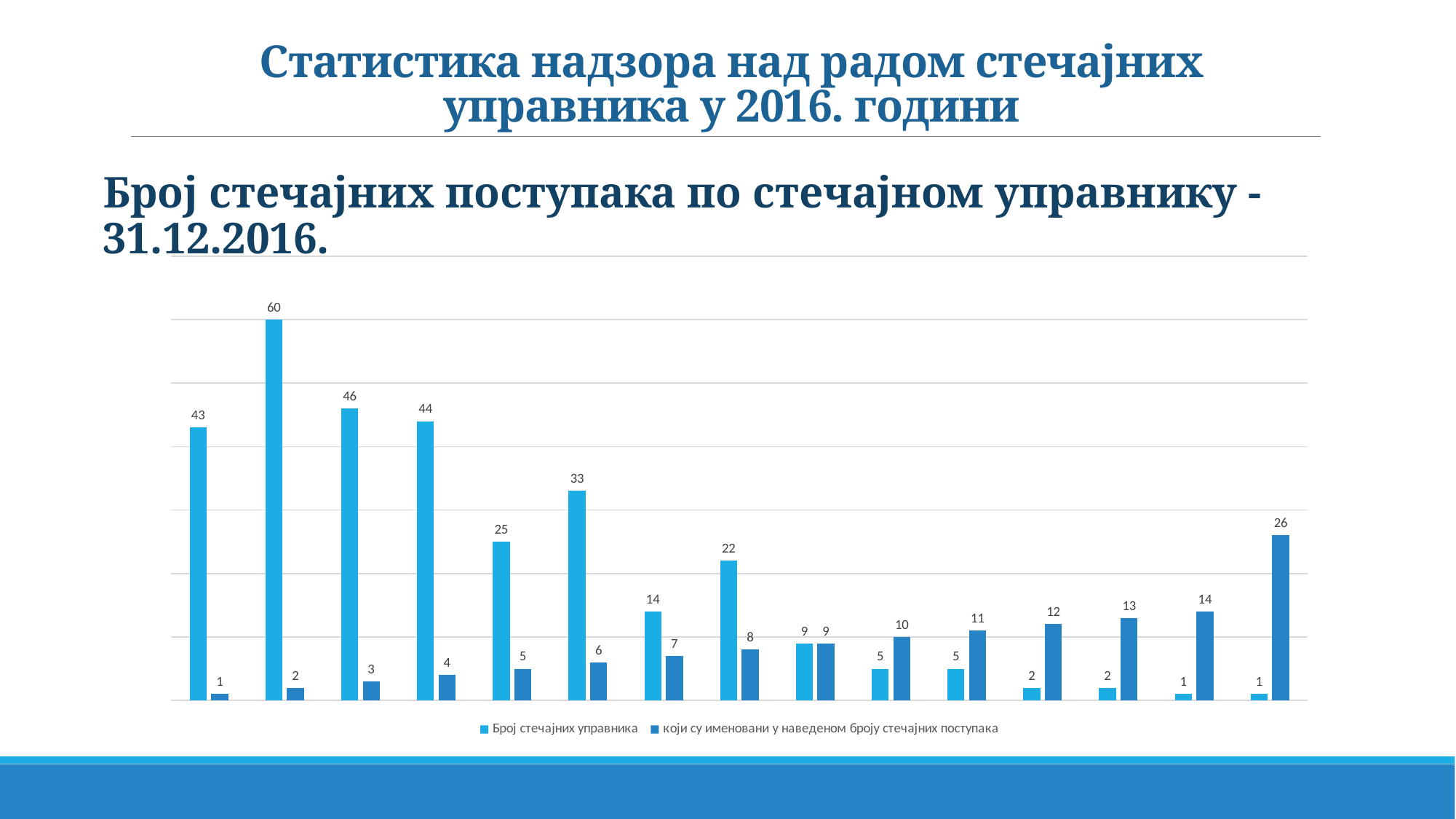
What is the value of the 'Број стечајних управника' bar in the first group from the left? 43 How many series does the legend list? 2 What is the highest value of the 'Број стечајних управника' series? 60 Which group has the larger 'Број стечајних управника' value: the third group (46) or the fourth group (44)? the third group (46) What is the total of the two bars in the first group from the left (43 and 1)? 44 What is the first legend entry of the chart? Број стечајних управника How many groups of bars are plotted along the x axis? 15 What kind of chart is shown on the slide? bar chart What is the value of the 'који су именовани у наведеном броју стечајних поступака' bar in the last group on the right? 26 In the ninth group from the left, what value do both bars show? 9 What is the lowest value of the 'који су именовани у наведеном броју стечајних поступака' series? 1